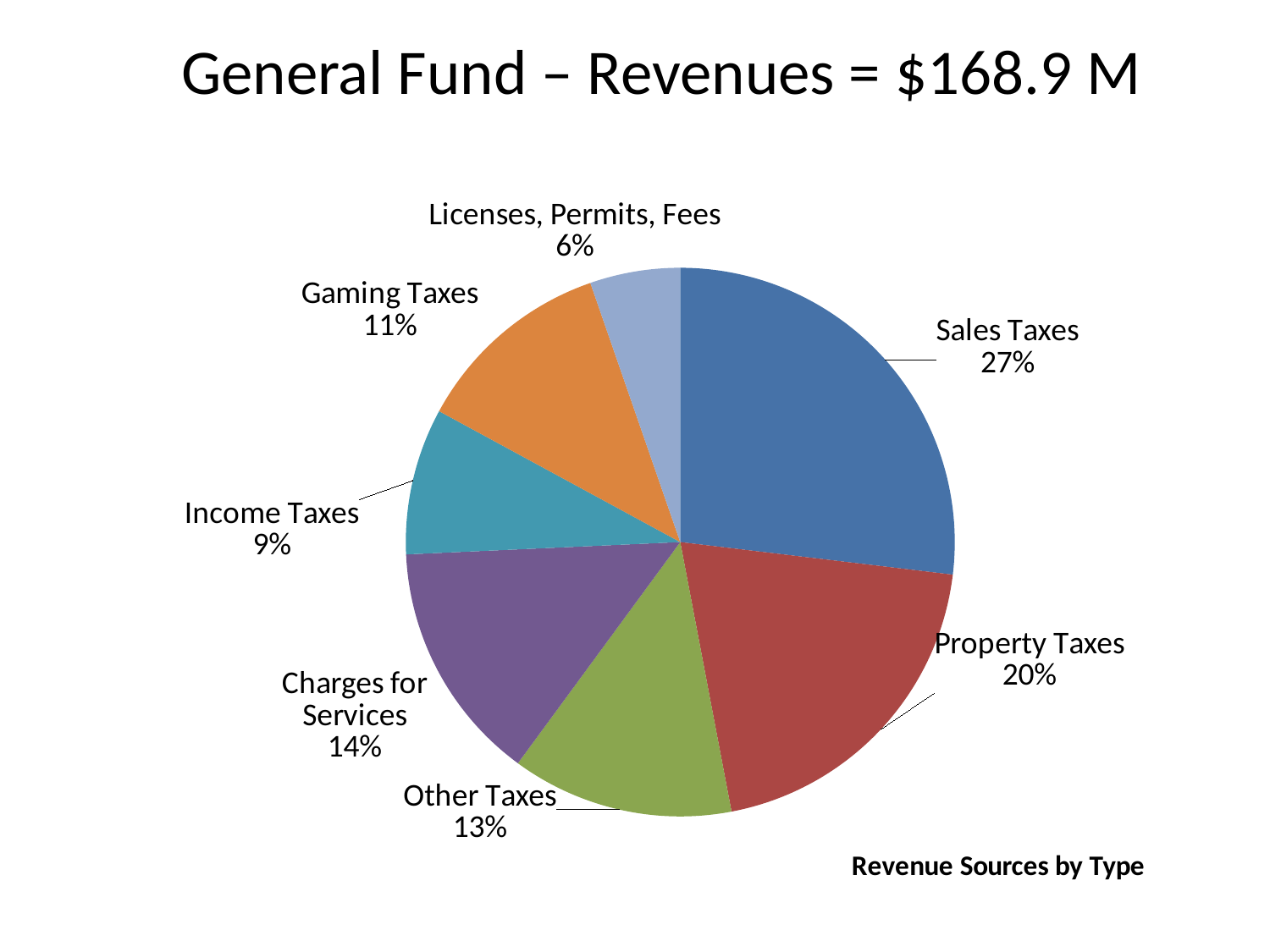
Which is larger, Gaming Taxes or Income Taxes? Gaming Taxes Which revenue source has the smallest share of the pie? Licenses, Permits, Fees What is the total General Fund revenue stated in the slide title? $168.9 M What share of General Fund revenues comes from Sales Taxes? 27% What percentage of revenues is from Property Taxes? 20% How many revenue categories are shown in the pie chart? 7 What type of chart is shown on the slide? Pie chart Which revenue source has the largest share of the pie? Sales Taxes What is the value shown for Charges for Services? 14% What is the difference in percentage points between Sales Taxes and Property Taxes? 7 What is the caption printed below the chart? Revenue Sources by Type What percentage does Licenses, Permits, Fees account for? 6%